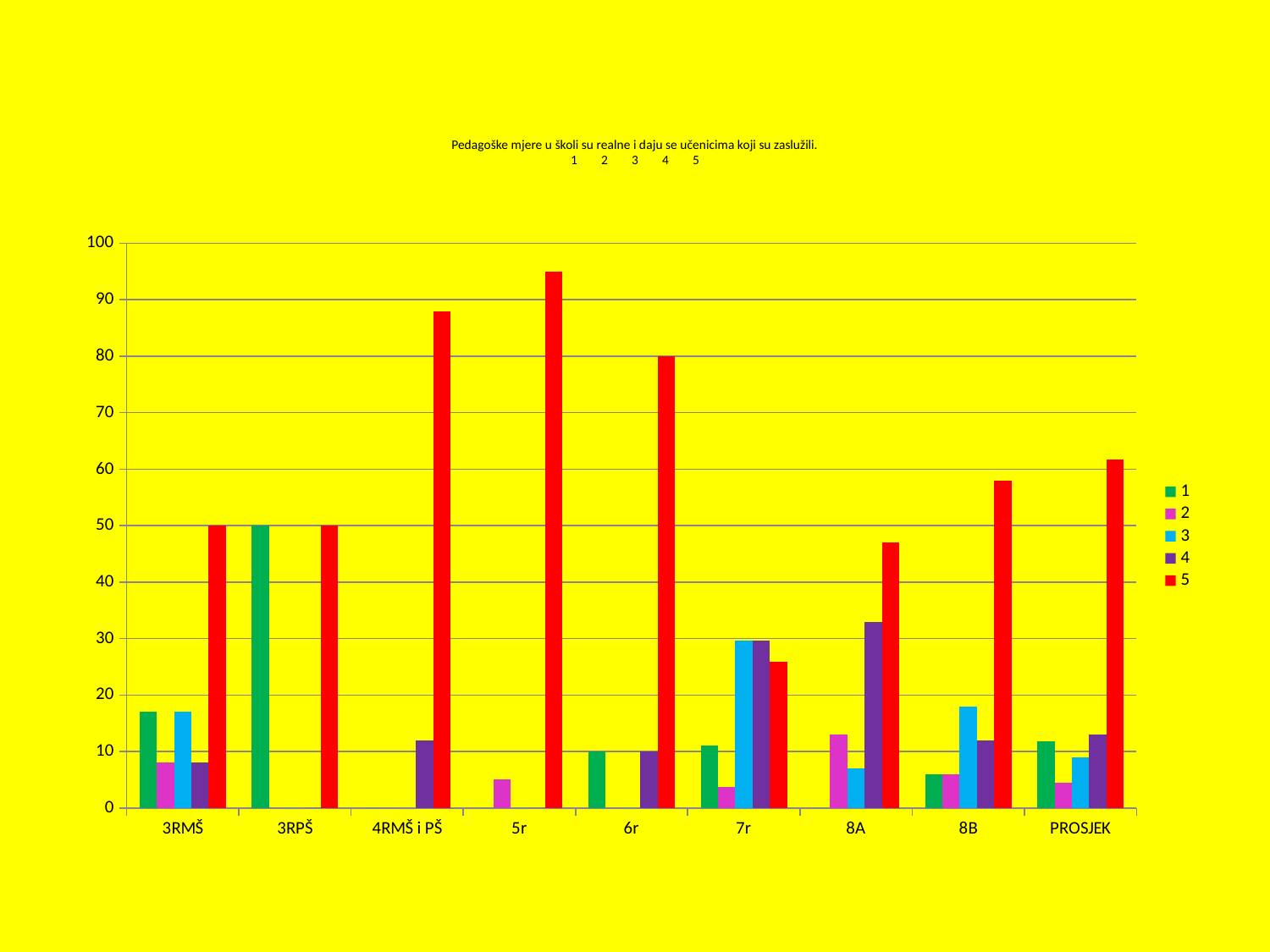
Which is larger for series 5: 4RMŠ i PŠ or 8B? 4RMŠ i PŠ Which category has the highest value for series 5? 5r What is the value of series 1 for 3RPŠ? 50 Which category is the last one on the x axis? PROSJEK Which category has the lowest value for series 5? 7r How many categories are shown on the x axis? 9 How many series does the legend list? 5 Is the value of series 5 for 5r greater or less than 90? greater What is the value of series 5 for 6r? 80 What is the value of series 5 for 3RMŠ? 50 What kind of chart is shown on the slide? bar chart Is the value of series 4 for 8A greater or less than 30? greater